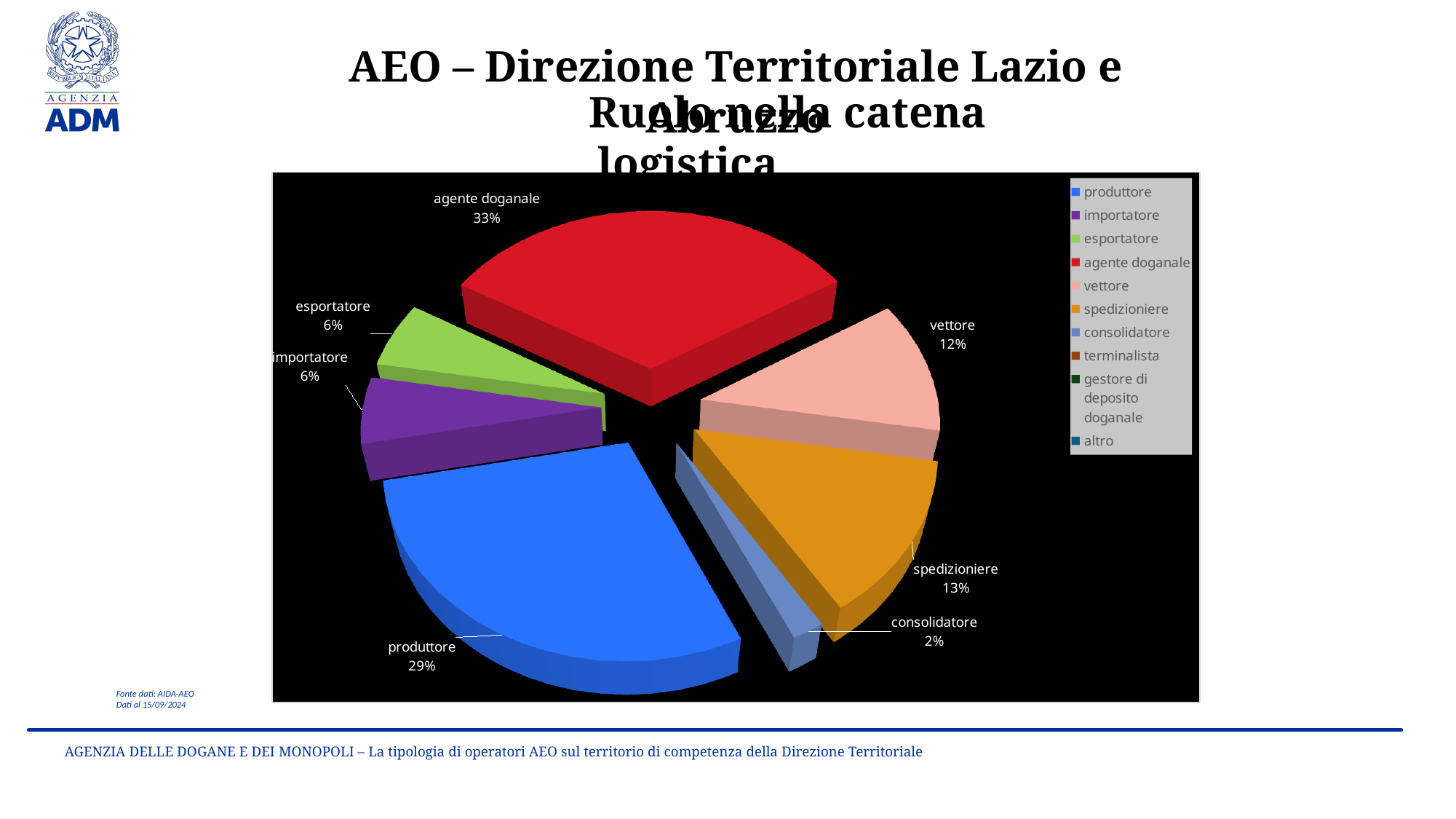
What share of the pie does agente doganale represent? 33% What is the difference in percentage points between agente doganale and produttore? 4 What percentage is shown for spedizioniere? 13% How many entries does the legend list? 10 What colour is the agente doganale slice? red Which is larger, the share for spedizioniere or the share for vettore? spedizioniere What is the value shown for produttore? 29% What percentage is shown for vettore? 12% Which category has the largest slice of the pie? agente doganale What kind of chart is shown on the slide? pie chart What percentage is shown for consolidatore? 2% Which labelled category has the smallest slice of the pie? consolidatore